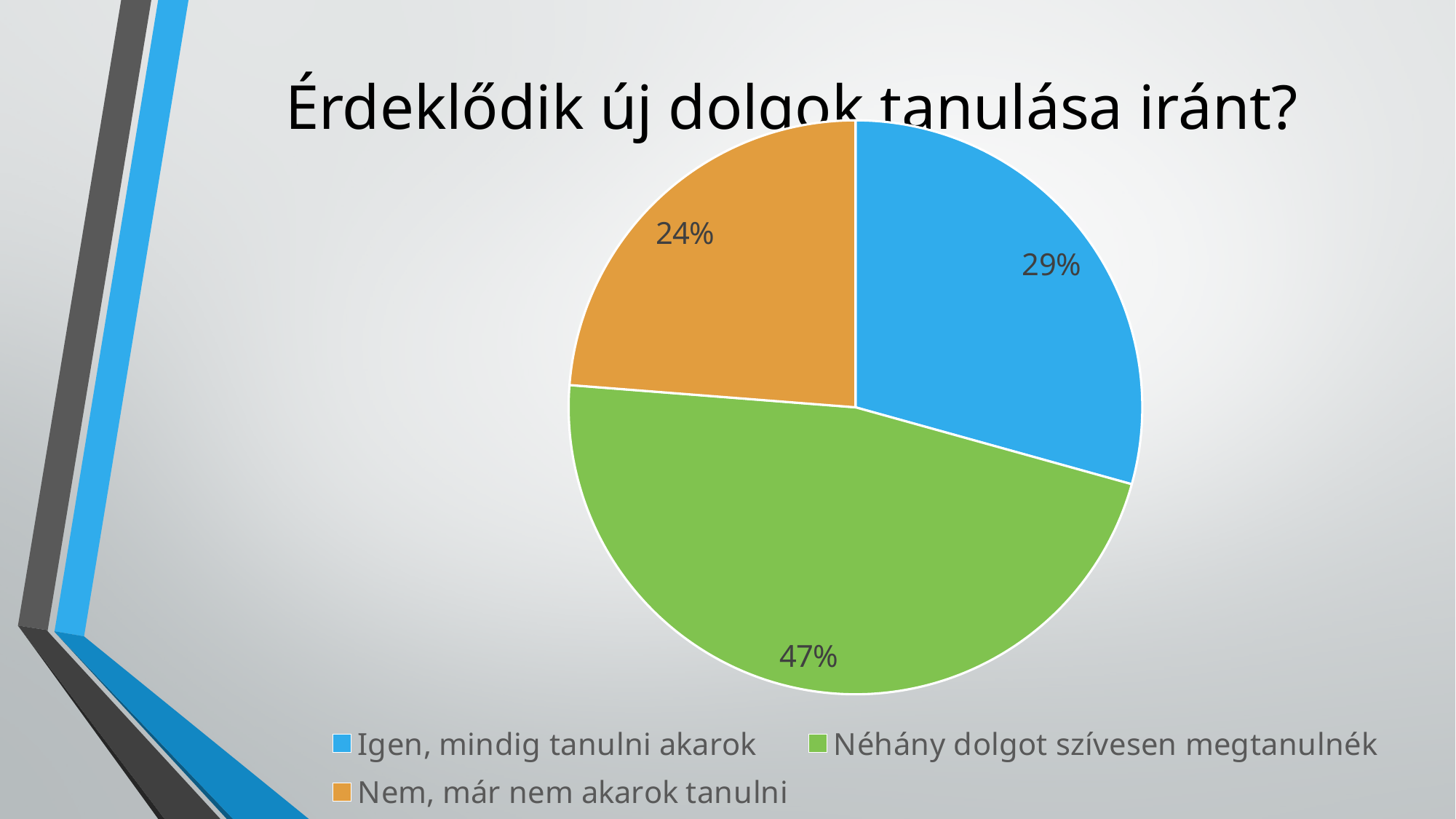
What is the difference in percentage points between "Néhány dolgot szívesen megtanulnék" and "Igen, mindig tanulni akarok"? 18 Which is larger: the share for "Igen, mindig tanulni akarok" or the share for "Nem, már nem akarok tanulni"? Igen, mindig tanulni akarok Which answer has the largest share of the pie? Néhány dolgot szívesen megtanulnék What colour is the slice for "Nem, már nem akarok tanulni"? orange What type of chart is shown on the slide? pie chart What is the difference in percentage points between "Igen, mindig tanulni akarok" and "Nem, már nem akarok tanulni"? 5 What percentage of respondents answered "Nem, már nem akarok tanulni"? 24% What percentage of respondents answered "Igen, mindig tanulni akarok"? 29% Which answer has the smallest share of the pie? Nem, már nem akarok tanulni What percentage of respondents answered "Néhány dolgot szívesen megtanulnék"? 47% How many slices does the pie chart have? 3 What is the title of the chart? Érdeklődik új dolgok tanulása iránt?